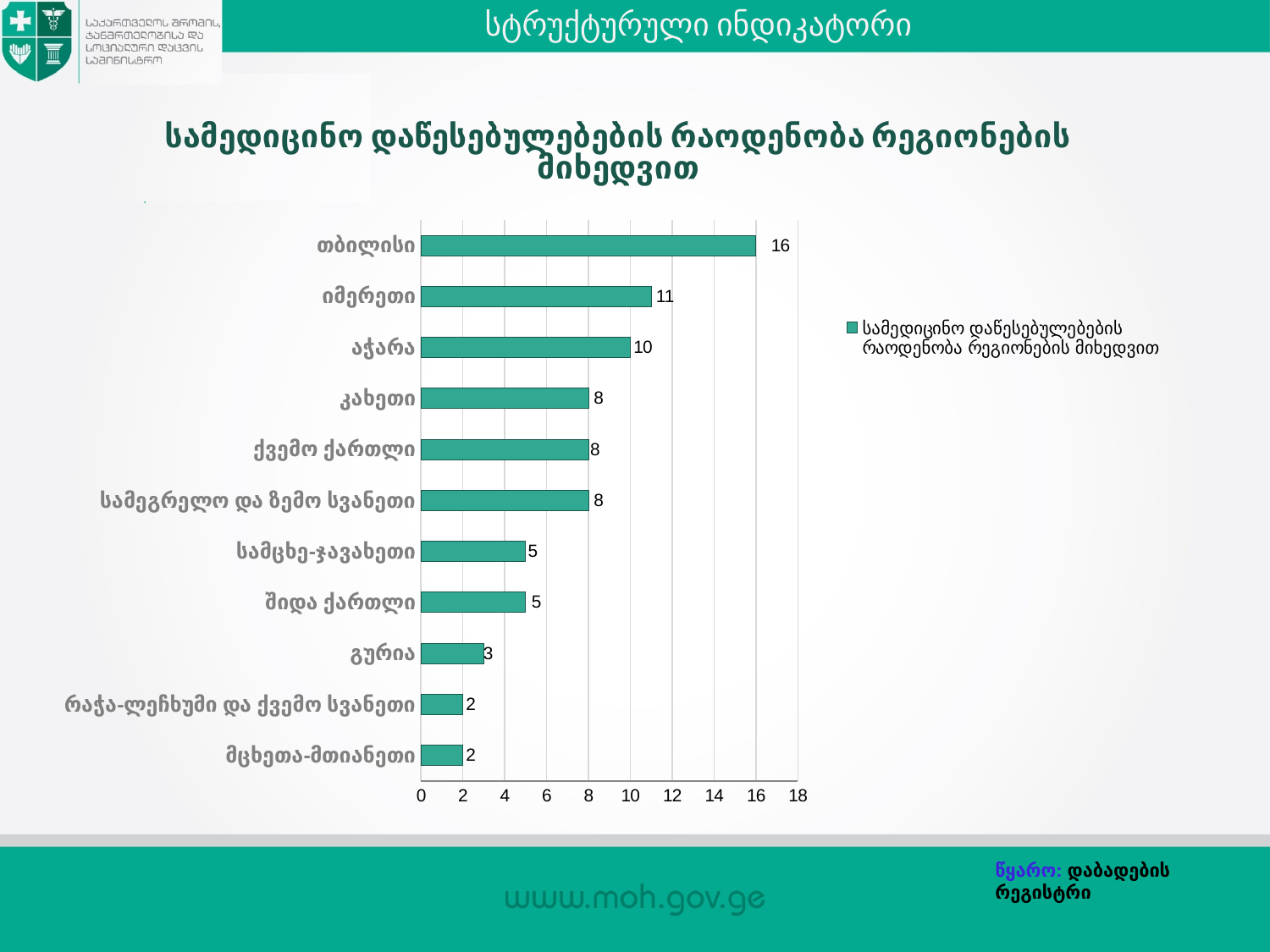
How many series does the legend list? 1 What is the value for აჭარა? 10 What is the value for იმერეთი? 11 Is the value for აჭარა greater or less than 8? greater What is the value for სამცხე-ჯავახეთი? 5 Which region has the highest value? თბილისი What is the value for თბილისი? 16 How many regions are shown in the chart? 11 What kind of chart is shown on the slide? bar chart What is the difference between the values for თბილისი and იმერეთი? 5 What is the value for გურია? 3 Which is larger, the value for კახეთი or the value for შიდა ქართლი? კახეთი